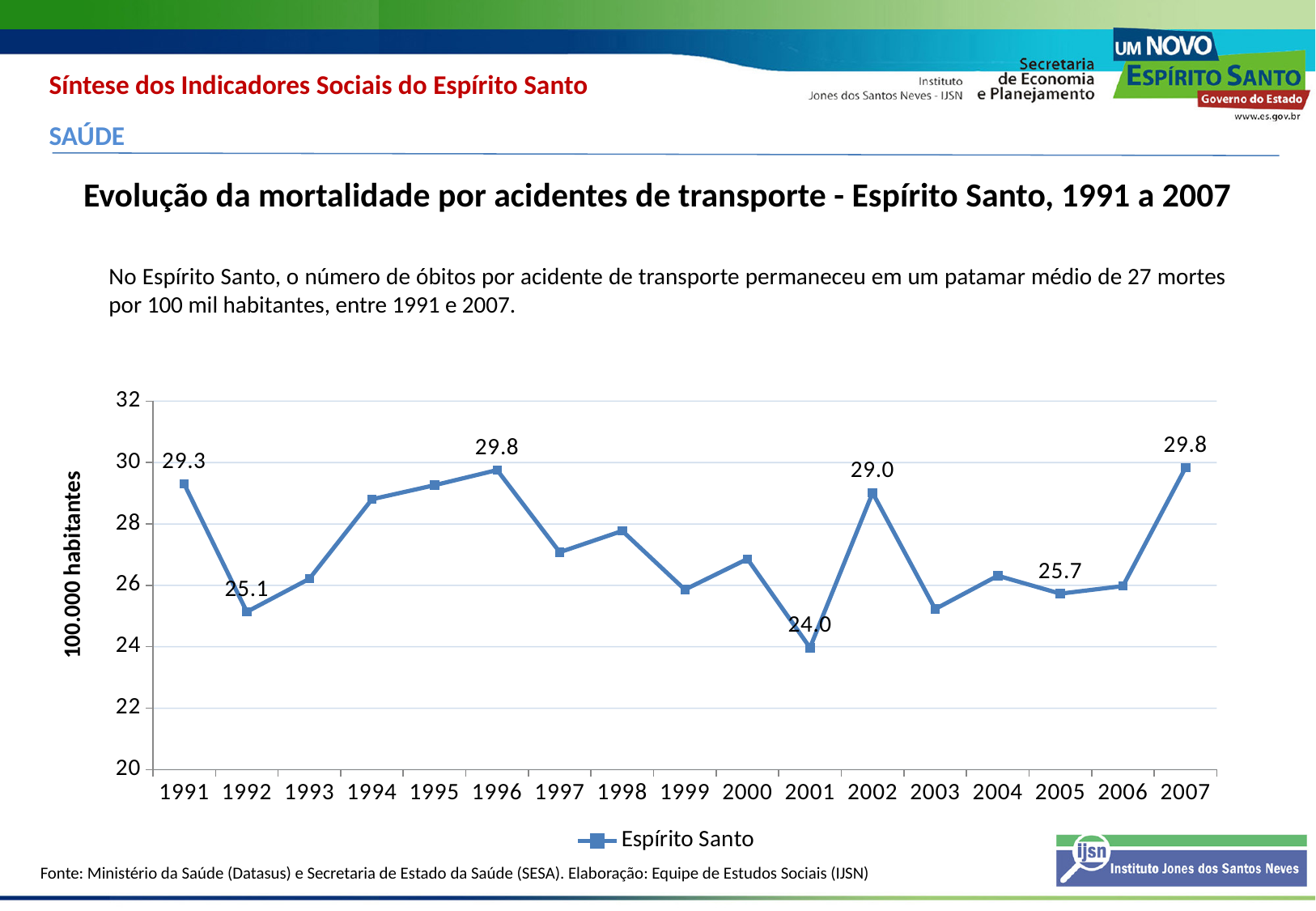
What is the value for 2005? 25.7 What is the difference between the values for 1991 and 1992? 4.2 Which is larger, the value for 2002 or the value for 2005? 2002 Is the value for 1994 greater or less than 28? greater Is the value for 2003 greater or less than 26? less How many years are plotted on the x axis? 17 What is the difference between the values for 1996 and 2001? 5.8 Which year has the lowest value? 2001 What is the value for 2001? 24.0 What is the value for 2002? 29.0 What is the value for 1991? 29.3 What kind of chart is shown? line chart